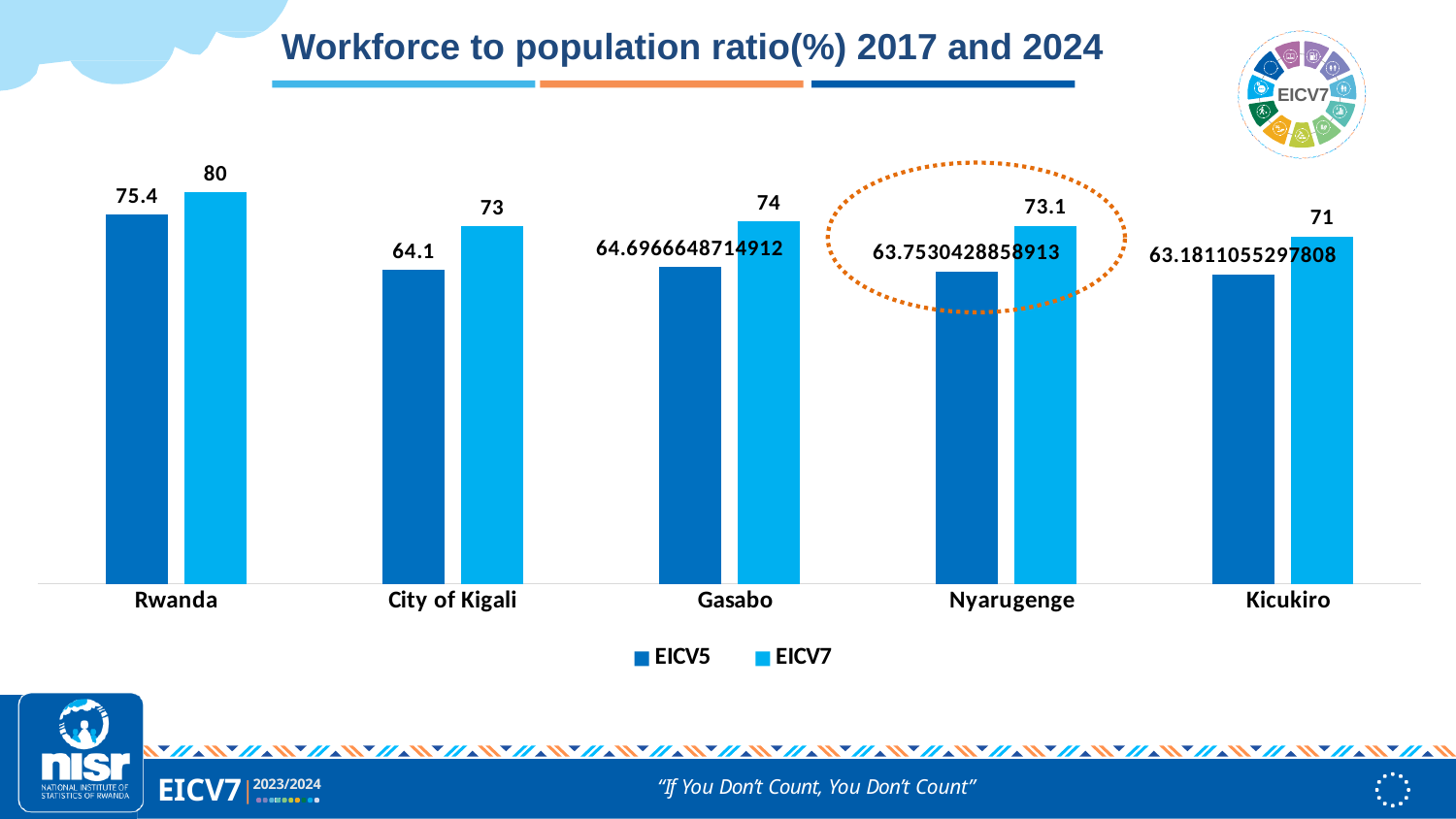
What kind of chart is shown on the slide? Bar chart What is the difference between the EICV7 and EICV5 values for City of Kigali? 8.9 Which category has the lowest EICV7 value? Kicukiro Which category has the highest EICV7 value? Rwanda What is the EICV7 value for Rwanda? 80 How many series does the legend list? 2 What is the EICV7 value for Nyarugenge? 73.1 What is the EICV7 value for Kicukiro? 71 Which is larger, the EICV7 value for Gasabo or the EICV7 value for Kicukiro? Gasabo How many categories are shown on the x axis? 5 What is the EICV5 value for City of Kigali? 64.1 What is the difference between the EICV7 and EICV5 values for Rwanda? 4.6